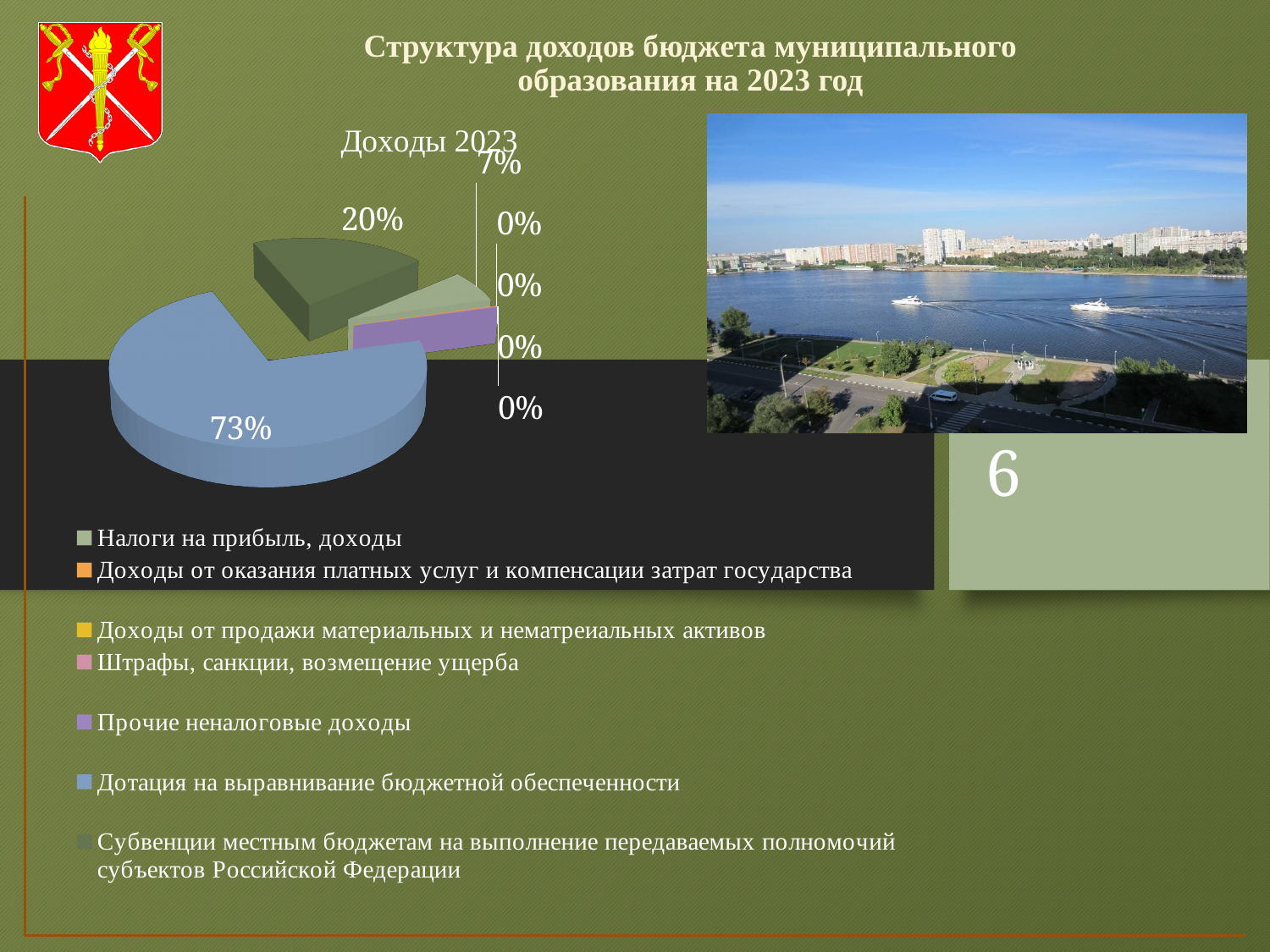
Which category has the largest slice of the pie? Дотация на выравнивание бюджетной обеспеченности What is the difference in percentage points between "Дотация на выравнивание бюджетной обеспеченности" and "Налоги на прибыль, доходы"? 66 percentage points Which is larger: the share for "Налоги на прибыль, доходы" or the share for "Субвенции местным бюджетам на выполнение передаваемых полномочий субъектов Российской Федерации"? Субвенции местным бюджетам на выполнение передаваемых полномочий субъектов Российской Федерации What kind of chart is shown on the slide? Pie chart What is the value shown for "Субвенции местным бюджетам на выполнение передаваемых полномочий субъектов Российской Федерации"? 20% What is the difference in percentage points between "Налоги на прибыль, доходы" and "Субвенции местным бюджетам на выполнение передаваемых полномочий субъектов Российской Федерации"? 13 percentage points What share of the pie does "Дотация на выравнивание бюджетной обеспеченности" take? 73% How many slices are labelled 0%? 4 What is the value shown for "Налоги на прибыль, доходы"? 7% What is the title of the chart? Доходы 2023 How many categories does the legend list? 7 What colour is the largest slice of the pie? Blue